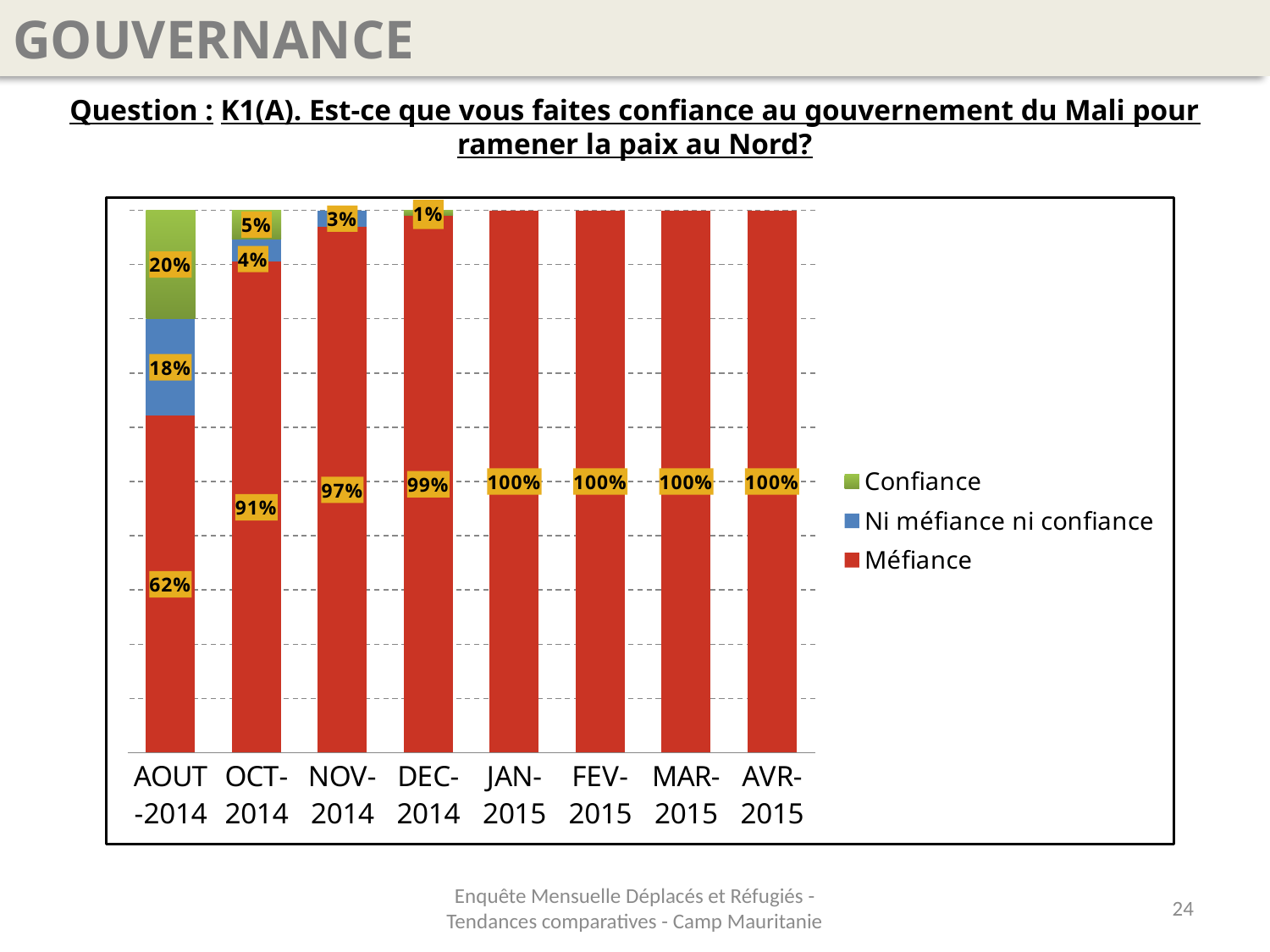
What is the Méfiance value for NOV-2014? 97% Which month has the lowest Méfiance value? AOUT-2014 What is the Ni méfiance ni confiance value for OCT-2014? 4% Which colour represents the Méfiance series? Red How many series does the legend list? 3 What kind of chart is shown on the slide? Stacked bar chart How many months are shown on the x axis? 8 Does the Méfiance value rise or fall from AOUT-2014 to AVR-2015? Rise Which is larger, the Confiance value for AOUT-2014 or the Confiance value for OCT-2014? AOUT-2014 What is the Confiance value for AOUT-2014? 20% What is the Méfiance value for AOUT-2014? 62% What is the difference between the Méfiance values for OCT-2014 and AOUT-2014? 29%